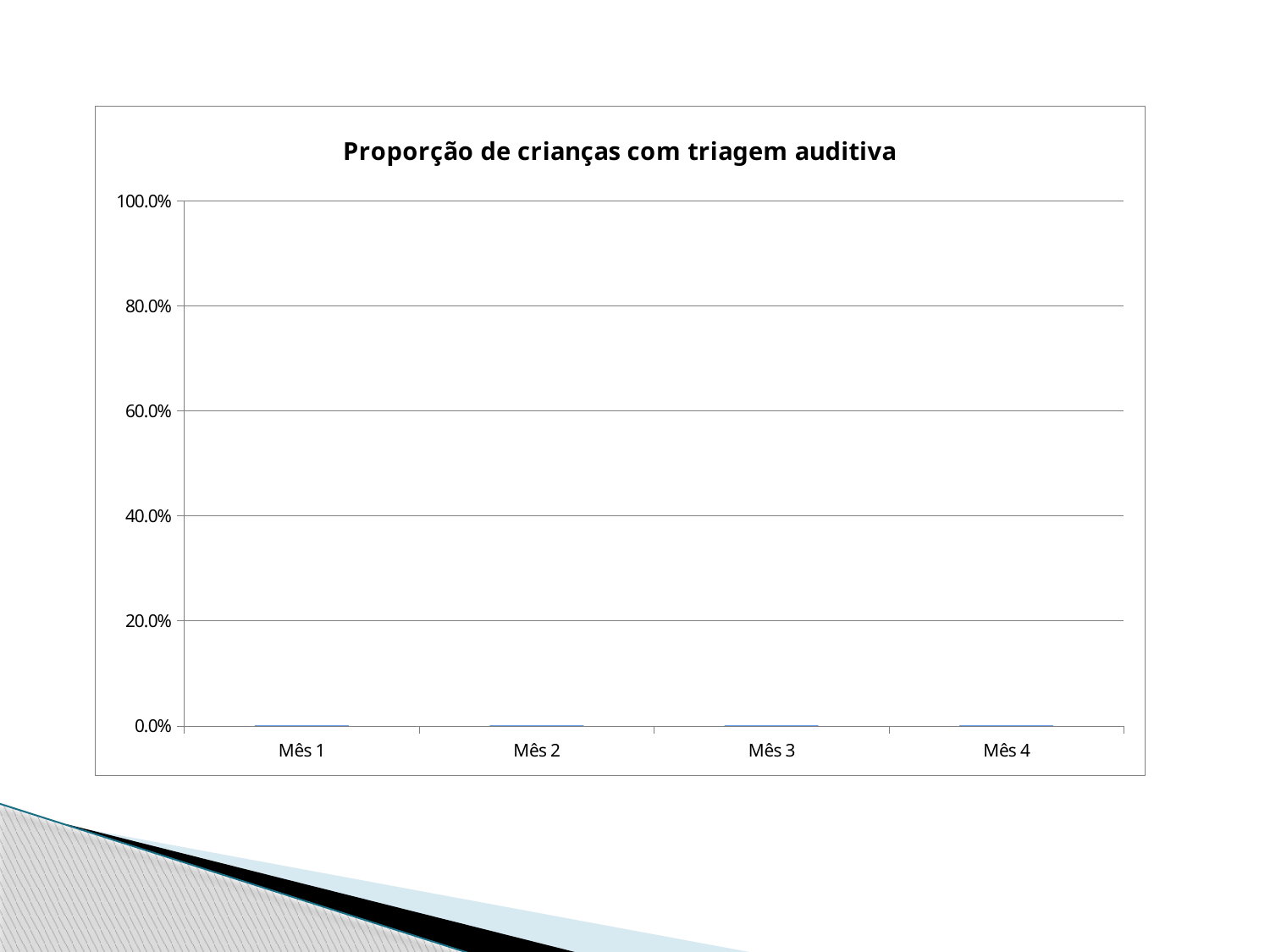
What kind of chart is shown on the slide? bar chart Is the value for Mês 3 greater or less than 40.0%? less What is the title of the chart? Proporção de crianças com triagem auditiva What is the value for Mês 2? 0.0% How many categories are shown on the x axis of the chart? 4 Is the value for Mês 4 greater or less than 20.0%? less What is the label of the first category on the x axis? Mês 1 What is the highest value shown on the y axis of the chart? 100.0% Is the value for Mês 1 greater or less than 20.0%? less